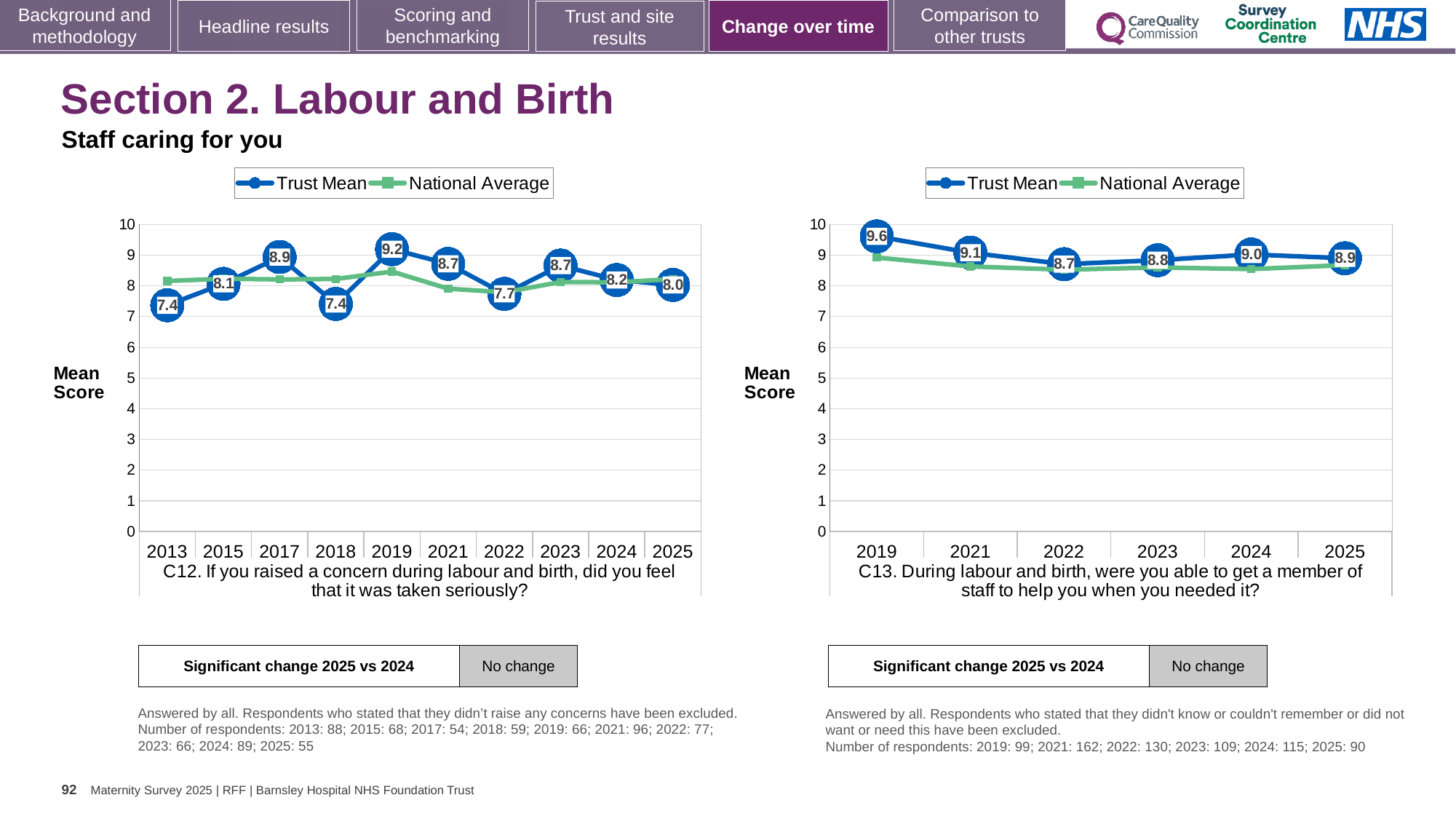
On the C13 chart (right), what is the difference between the Trust Mean in 2019 and the Trust Mean in 2025? 0.7 On the C12 chart (left), how many years are plotted on the x axis? 10 On the C12 chart (left), what is the Trust Mean for 2025? 8.0 On the C12 chart (left), which year has the highest Trust Mean? 2019 What kind of chart is the C12 chart (left)? Line chart On the C13 chart (right), what is the Trust Mean for 2019? 9.6 On the C12 chart (left), what is the Trust Mean for 2019? 9.2 On the C12 chart (left), what is the difference between the Trust Mean in 2019 and the Trust Mean in 2022? 1.5 How many series does the legend of the C13 chart (right) list? 2 On the C13 chart (right), which year has the lowest Trust Mean? 2022 On the C13 chart (right), is the National Average for 2019 greater or less than 8? greater On the C12 chart (left), is the Trust Mean for 2017 greater or less than the Trust Mean for 2018? greater